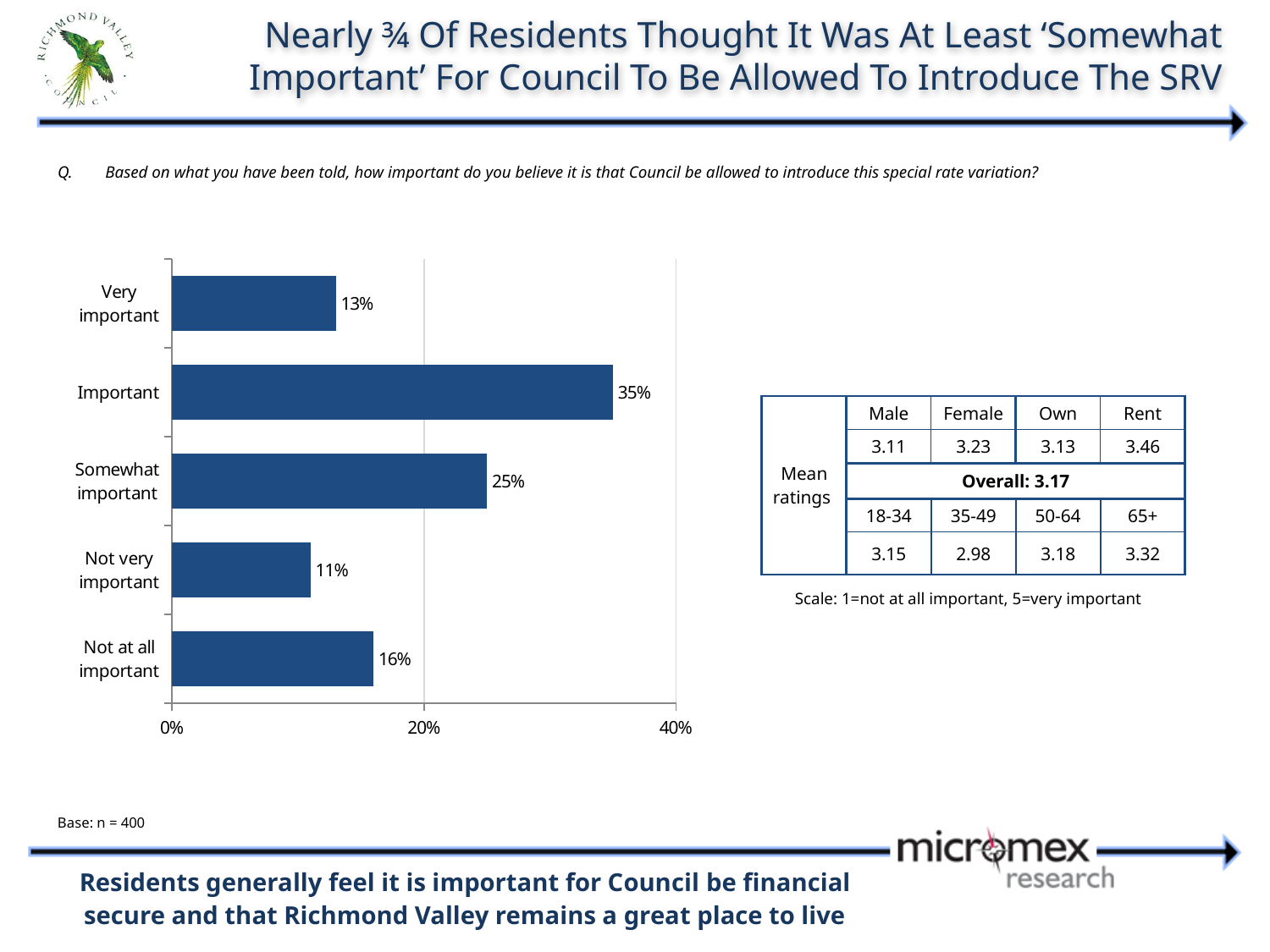
What percentage of residents said it was 'Important'? 35% What is the maximum value shown on the percentage axis of the chart? 40% How many categories are shown in the bar chart? 5 What kind of chart is shown on the slide? Bar chart Is the value for 'Somewhat important' greater or less than 20%? greater What percentage of residents said it was 'Not at all important'? 16% What percentage of residents said it was 'Very important'? 13% Which category has the lowest percentage? Not very important What is the combined percentage of 'Very important', 'Important' and 'Somewhat important'? 73% What is the difference in percentage points between 'Important' and 'Somewhat important'? 10 Which category has the highest percentage? Important Which is larger, the percentage for 'Not at all important' or for 'Very important'? Not at all important